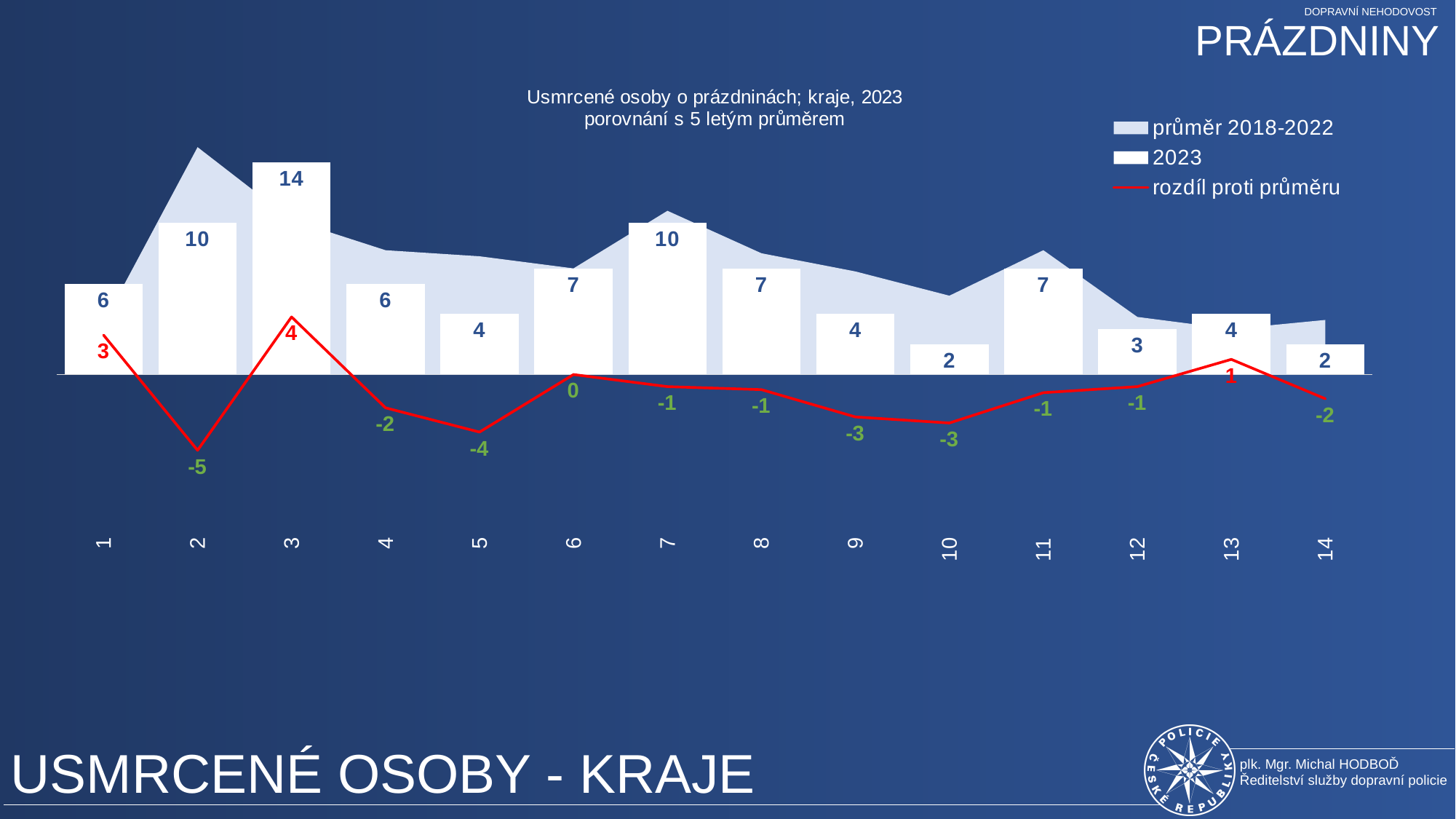
Which has a larger 2023 value, category 7 or category 11? category 7 What is the value of the 'rozdíl proti průměru' line for category 13? 1 What is the value of the 'rozdíl proti průměru' line for category 2? -5 How many series does the legend list? 3 What colour is the 'rozdíl proti průměru' line? red What is the 2023 value for category 3? 14 Which category has the lowest value on the 'rozdíl proti průměru' line? 2 How many categories are shown on the x axis? 14 What is the title of the chart? Usmrcené osoby o prázdninách; kraje, 2023 porovnání s 5 letým průměrem What is the 2023 value for category 10? 2 What is the difference between the 2023 values for category 3 and category 2? 4 Which category has the highest 2023 value? 3